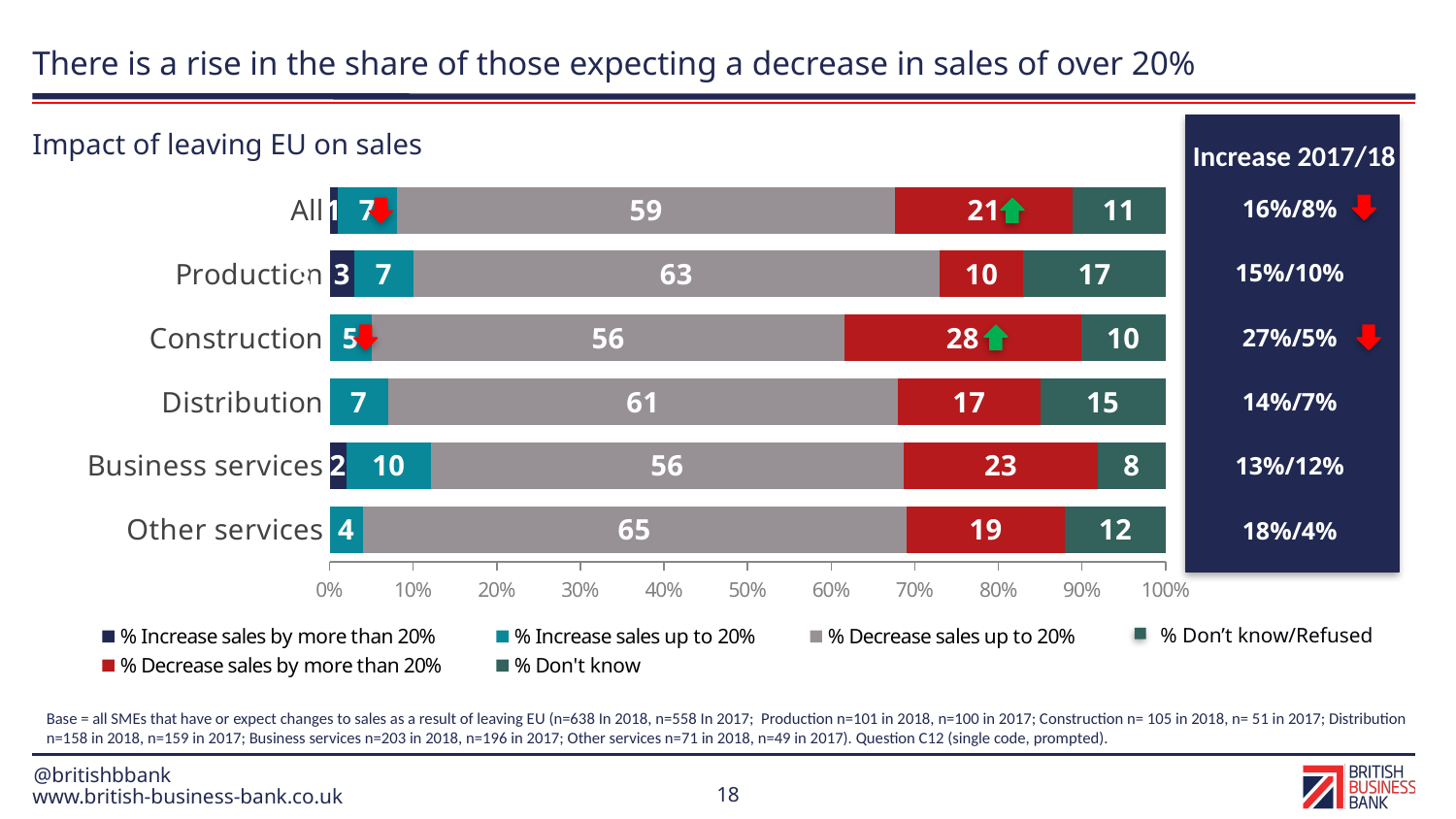
Which category has the highest value for '% Decrease sales by more than 20%'? Construction What is the value for '% Don't know' for Production? 17 What is the difference between the '% Decrease sales by more than 20%' values for Business services and Production? 13 Which category has the lowest value for '% Don't know'? Business services What is the title of the chart? Impact of leaving EU on sales How many series does the legend list? 6 What type of chart is shown on the slide? Stacked bar chart What is the value for '% Decrease sales up to 20%' for Other services? 65 Which is larger: the '% Decrease sales up to 20%' value for Production or for Distribution? Production What is the value for '% Decrease sales by more than 20%' for Construction? 28 What is the value for '% Increase sales up to 20%' for Business services? 10 How many categories are shown on the chart? 6